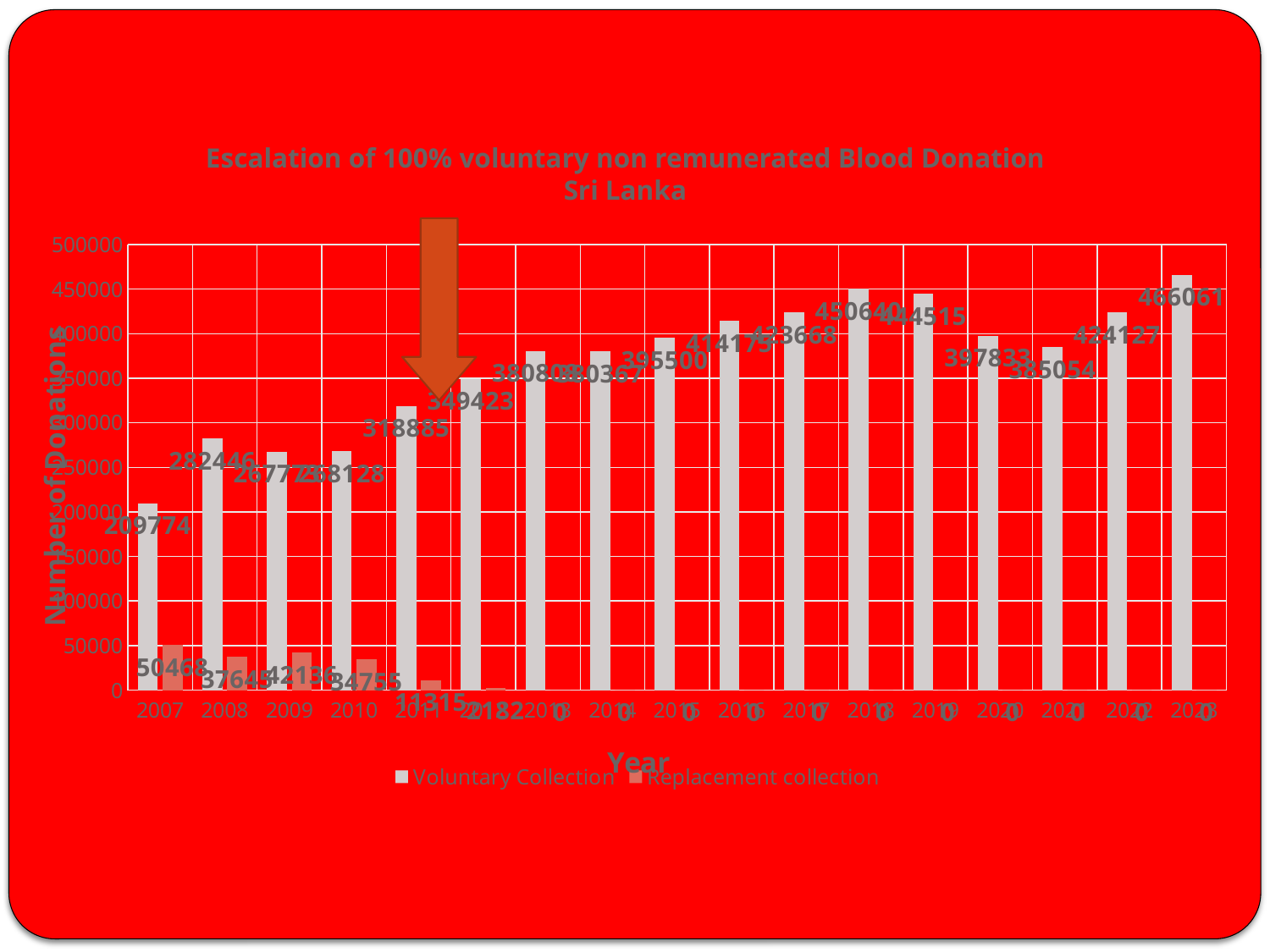
What is the difference between the Voluntary Collection values for 2023 and 2007? 256287 How many years are shown on the x axis? 17 What is the Voluntary Collection value for 2018? 450640 Which year has the highest Voluntary Collection? 2023 What is the Replacement collection value for 2007? 50468 How many series does the legend list? 2 Which year has the lowest Voluntary Collection? 2007 What is the Voluntary Collection value for 2007? 209774 Is the Voluntary Collection value for 2016 greater or less than 400000? greater What is the Voluntary Collection value for 2023? 466061 Which is larger, the Voluntary Collection for 2018 or for 2019? 2018 What kind of chart is shown on the slide? bar chart